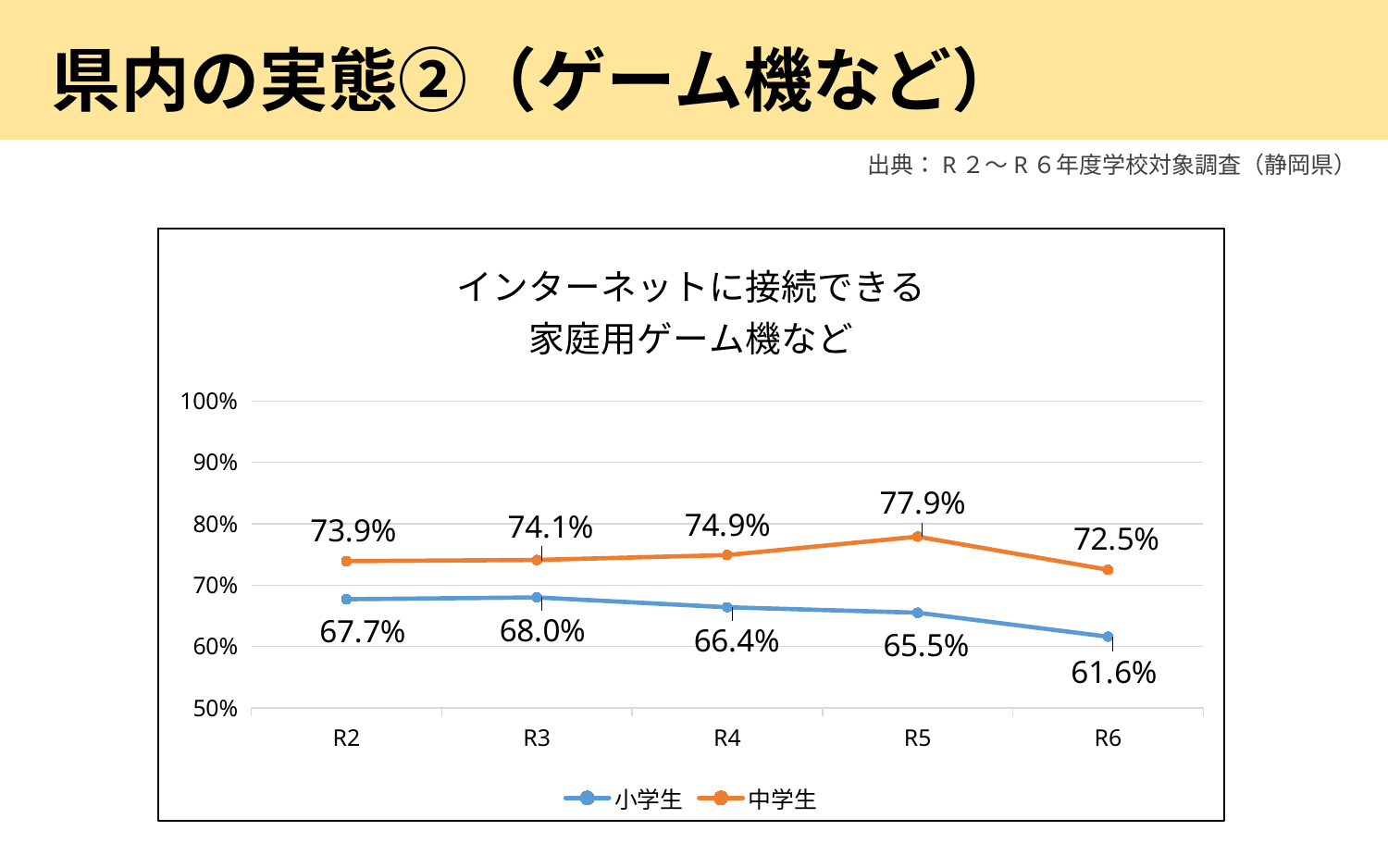
Is the value for 中学生 in R6 greater or less than 70%? greater What kind of chart is shown on the slide? line chart What is the value for 小学生 in R6? 61.6% Which series has the larger value in R2, 小学生 or 中学生? 中学生 What is the difference between the 中学生 and 小学生 values in R5? 12.4% In which year is the 小学生 value lowest? R6 How many years are shown on the x axis? 5 How many series does the legend list? 2 Does the 小学生 series rise or fall from R3 to R6? fall In which year is the 中学生 value highest? R5 What is the value for 中学生 in R5? 77.9% What is the value for 小学生 in R3? 68.0%